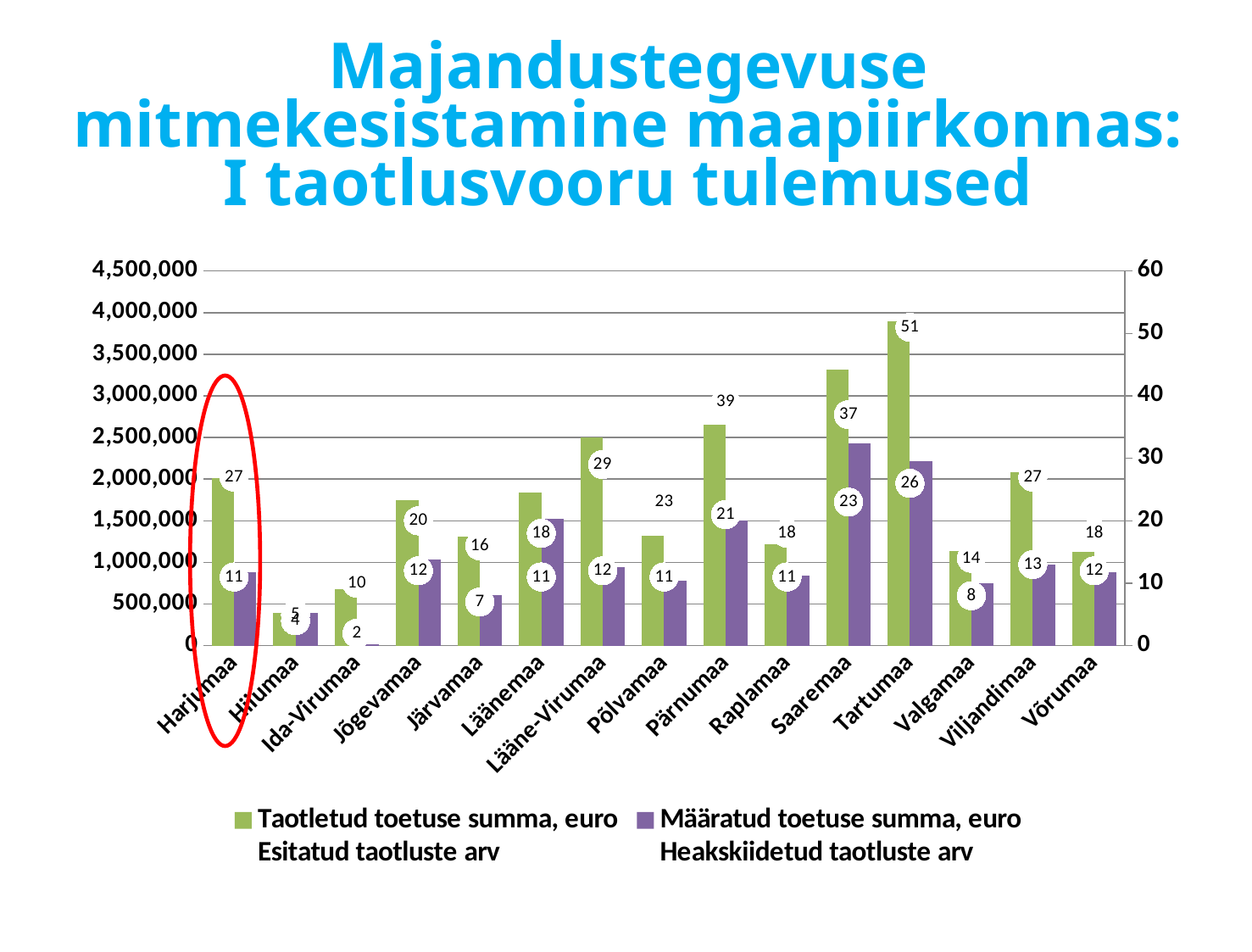
Which county is circled in red on the chart? Harjumaa How many series does the chart legend list? 4 What is the Heakskiidetud taotluste arv (number of approved applications) for Harjumaa? 11 Which county has the tallest green bar (Taotletud toetuse summa, euro)? Tartumaa How many counties (categories) are shown on the x axis of the chart? 15 Which county has the lowest Esitatud taotluste arv? Hiiumaa What kind of chart is shown on the slide? bar chart What is the difference between the Esitatud taotluste arv and the Heakskiidetud taotluste arv for Tartumaa? 25 Which county has more submitted applications (Esitatud taotluste arv), Pärnumaa or Saaremaa? Pärnumaa What is the Esitatud taotluste arv (number of submitted applications) for Tartumaa? 51 Is the Taotletud toetuse summa (requested support amount) for Tartumaa greater or less than 3,500,000? greater Which county has the highest Esitatud taotluste arv? Tartumaa